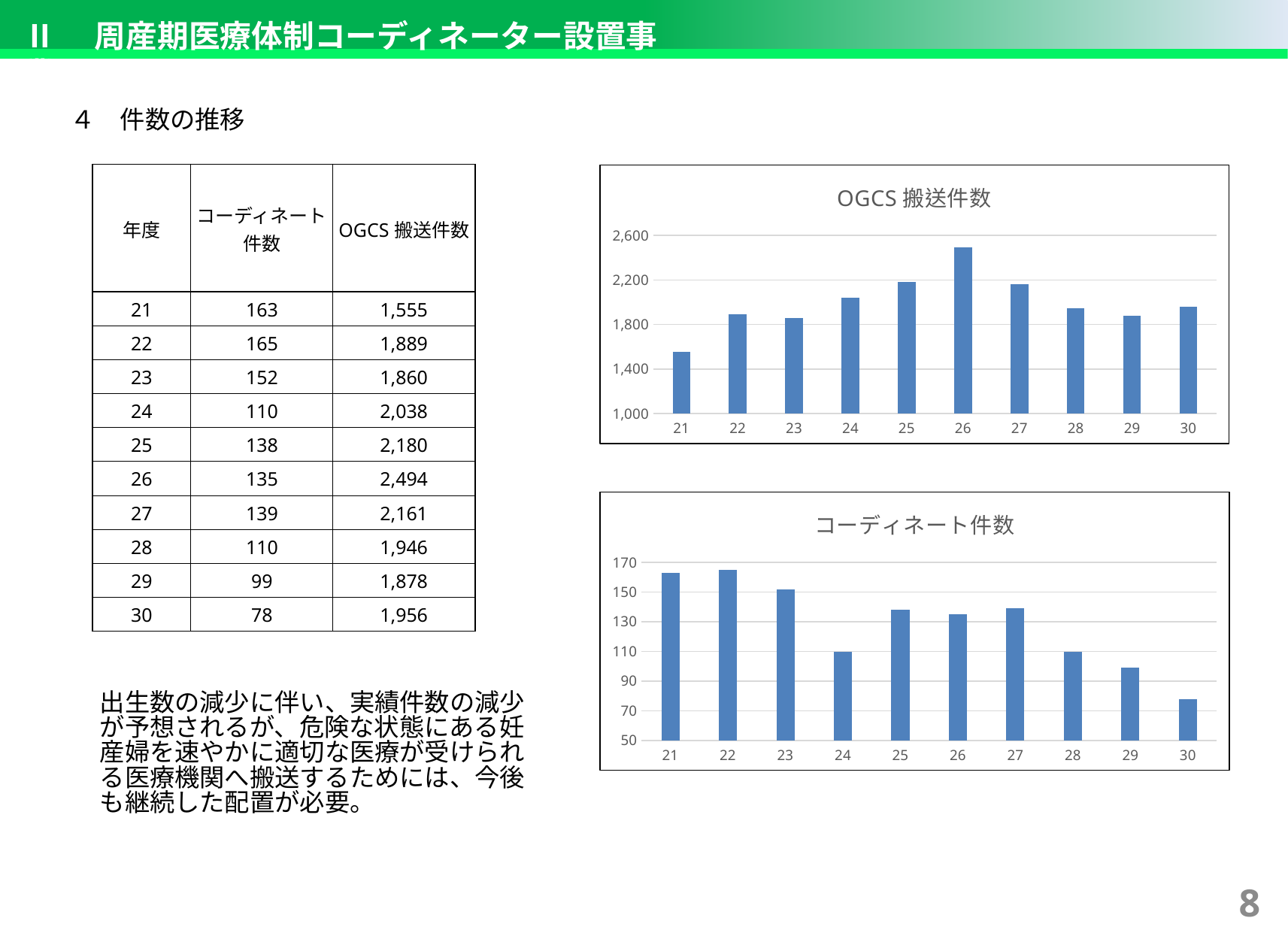
How many years are shown on the x axis of the OGCS 搬送件数 chart? 10 In the コーディネート件数 chart, is the value for year 29 greater or less than 110? less In the コーディネート件数 chart, what is the value for year 30 as printed in the table on the slide? 78 In the OGCS 搬送件数 chart, which year has the highest value? 26 In the コーディネート件数 chart, which year has the highest value? 22 In the OGCS 搬送件数 chart, is the value for year 21 greater or less than 1,800? less In the OGCS 搬送件数 chart, is the value for year 26 greater or less than 2,200? greater In the OGCS 搬送件数 chart, which year has the lowest value? 21 What is the title of the lower chart on the slide? コーディネート件数 In the コーディネート件数 chart, is the value for year 27 larger or smaller than the value for year 24? larger What type of chart is the OGCS 搬送件数 chart? bar chart In the コーディネート件数 chart, which year has the lowest value? 30